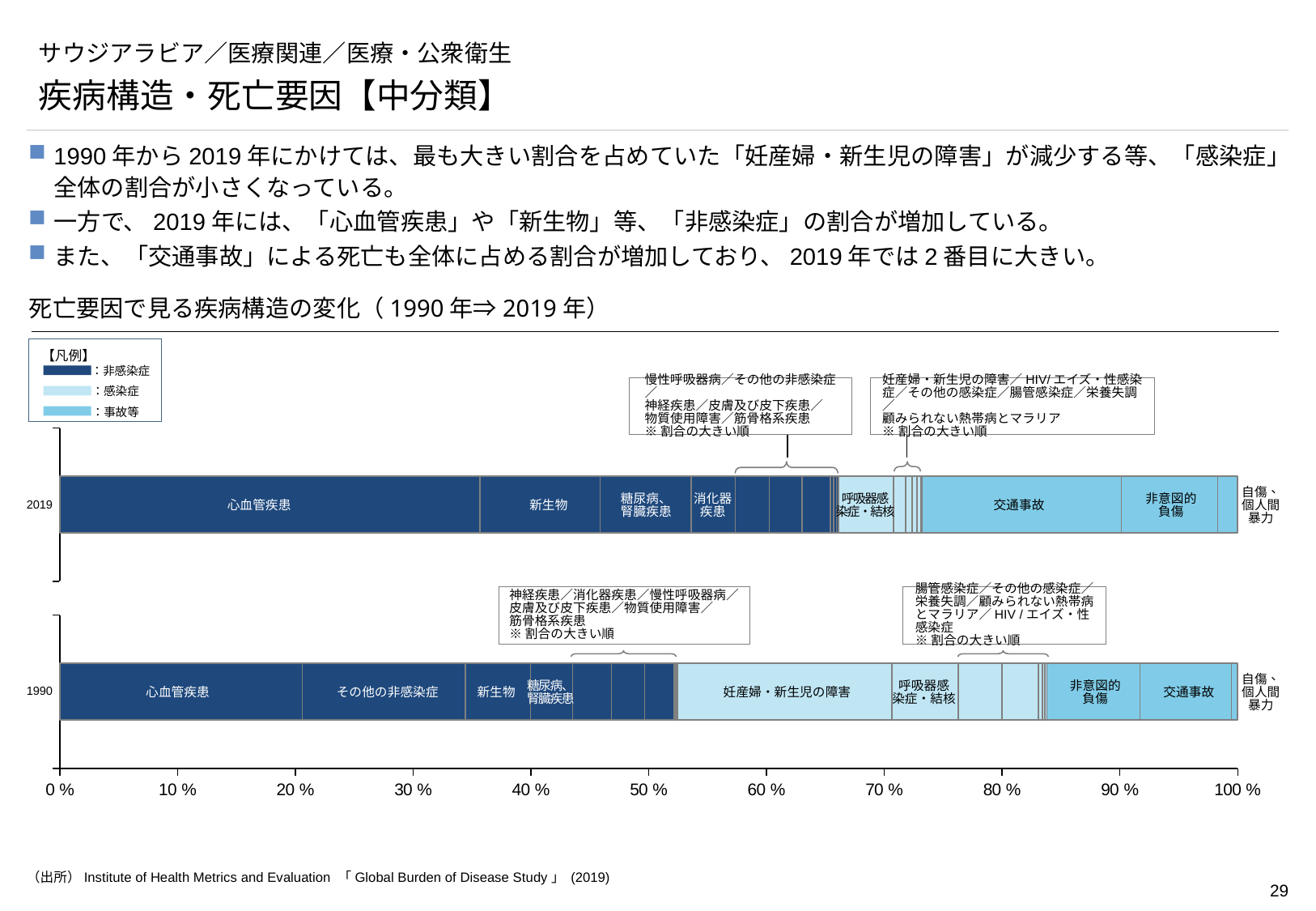
Which year has the larger share for 心血管疾患, 1990 or 2019? 2019 Which year has the larger share for 交通事故, 1990 or 2019? 2019 Which year has the larger share for 新生物, 1990 or 2019? 2019 Which category has the largest share in the 2019 bar? 心血管疾患 Is the share of 交通事故 in 2019 greater or less than 10%? greater Is the share of 妊産婦・新生児の障害 in 1990 greater or less than 10%? greater Which group does the dark blue colour represent in the legend? 非感染症 How many groups does the legend (凡例) list? 3 Is the share of 心血管疾患 in 2019 greater or less than 30%? greater Did the share of 心血管疾患 rise or fall from 1990 to 2019? Rise How many years (bars) does the chart compare? 2 What kind of chart is shown on the slide? Stacked bar chart